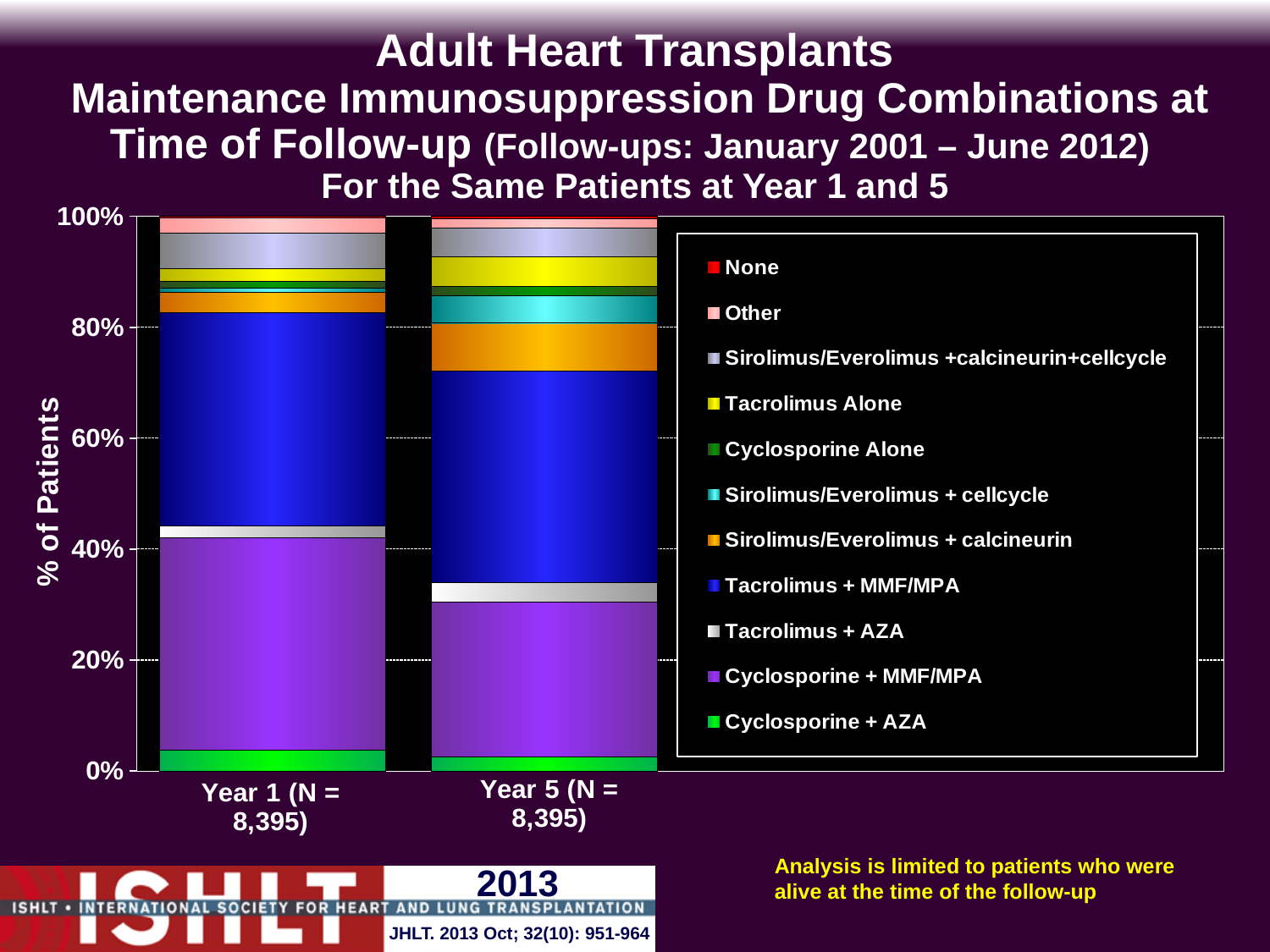
Is the Tacrolimus + MMF/MPA share in the Year 1 bar greater or less than 20%? greater Which bar has the larger Sirolimus/Everolimus + calcineurin share, Year 1 or Year 5? Year 5 What is the label of the y axis? % of Patients How many series does the legend list? 11 How many bars (categories) are plotted on the chart? 2 Is the Cyclosporine + MMF/MPA share in the Year 1 bar greater or less than 20%? greater What is the label of the first bar on the chart? Year 1 (N = 8,395) What is the total height of the Year 5 stacked bar? 100% What kind of chart is shown on the slide? Stacked bar chart Is the Cyclosporine + AZA share in the Year 5 bar greater or less than 20%? less Which bar has the larger Cyclosporine + MMF/MPA share, Year 1 or Year 5? Year 1 Which bar has the larger Tacrolimus Alone share, Year 1 or Year 5? Year 5